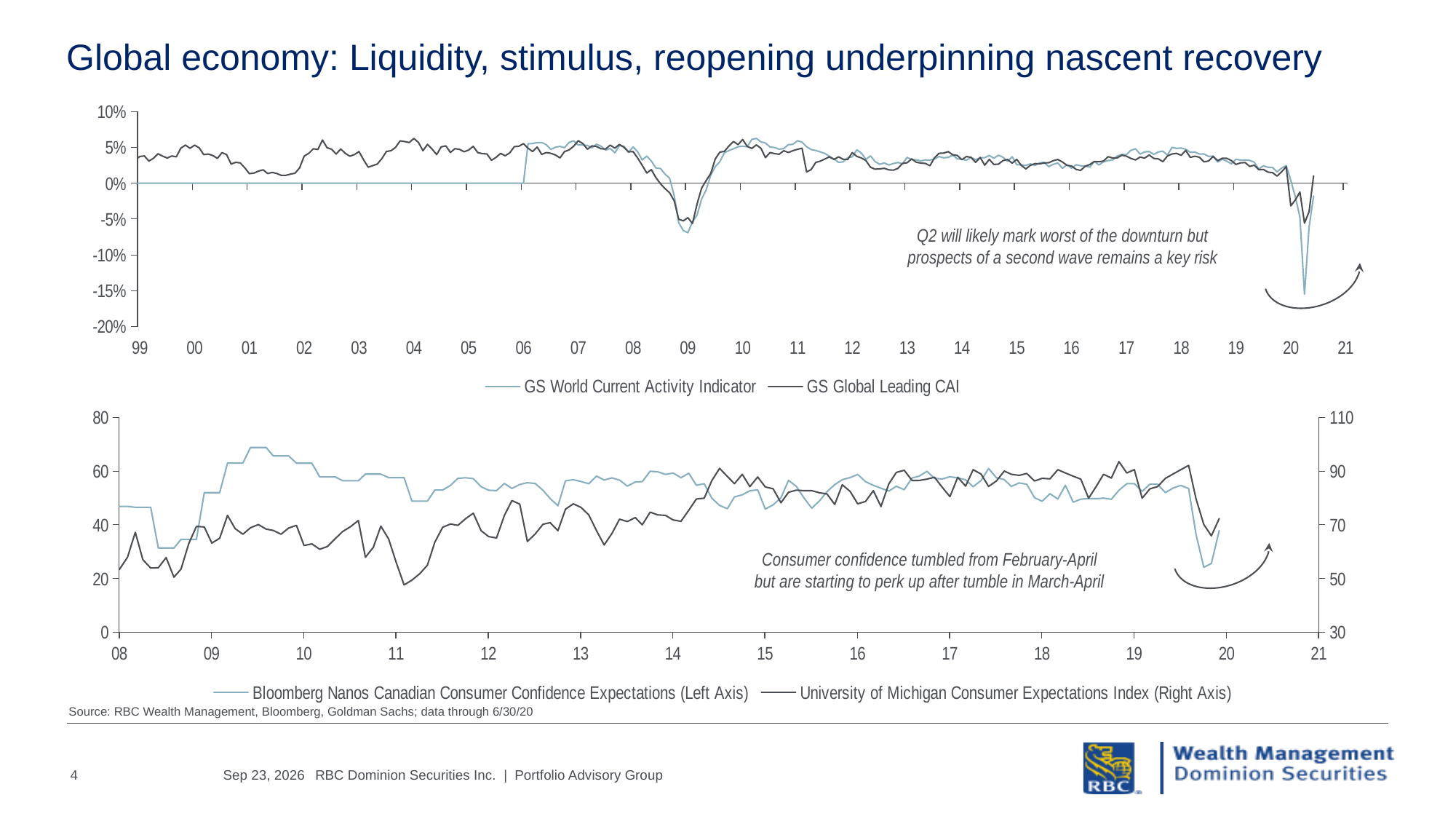
In the bottom chart, did the Bloomberg Nanos Canadian Consumer Confidence Expectations series rise or fall between 2019 and early 2020? Fall In the top chart, which series is plotted in black? GS Global Leading CAI What kind of chart is the top chart on the slide? Line chart How many series does the legend of the bottom chart list? 2 What kind of chart is the bottom chart on the slide? Line chart In the bottom chart, is the 2020 trough of the Bloomberg Nanos Canadian Consumer Confidence Expectations series greater or less than 40? less In the bottom chart, which series is plotted against the right axis? University of Michigan Consumer Expectations Index In the top chart, is the lowest value of the GS Global Leading CAI in 2009 greater or less than 0%? less How many series does the legend of the top chart list? 2 In the bottom chart, is the peak of the Bloomberg Nanos Canadian Consumer Confidence Expectations series around 2009-2010 greater or less than 60? greater In the top chart, which series reaches a lower value in 2020, the GS World Current Activity Indicator or the GS Global Leading CAI? GS World Current Activity Indicator